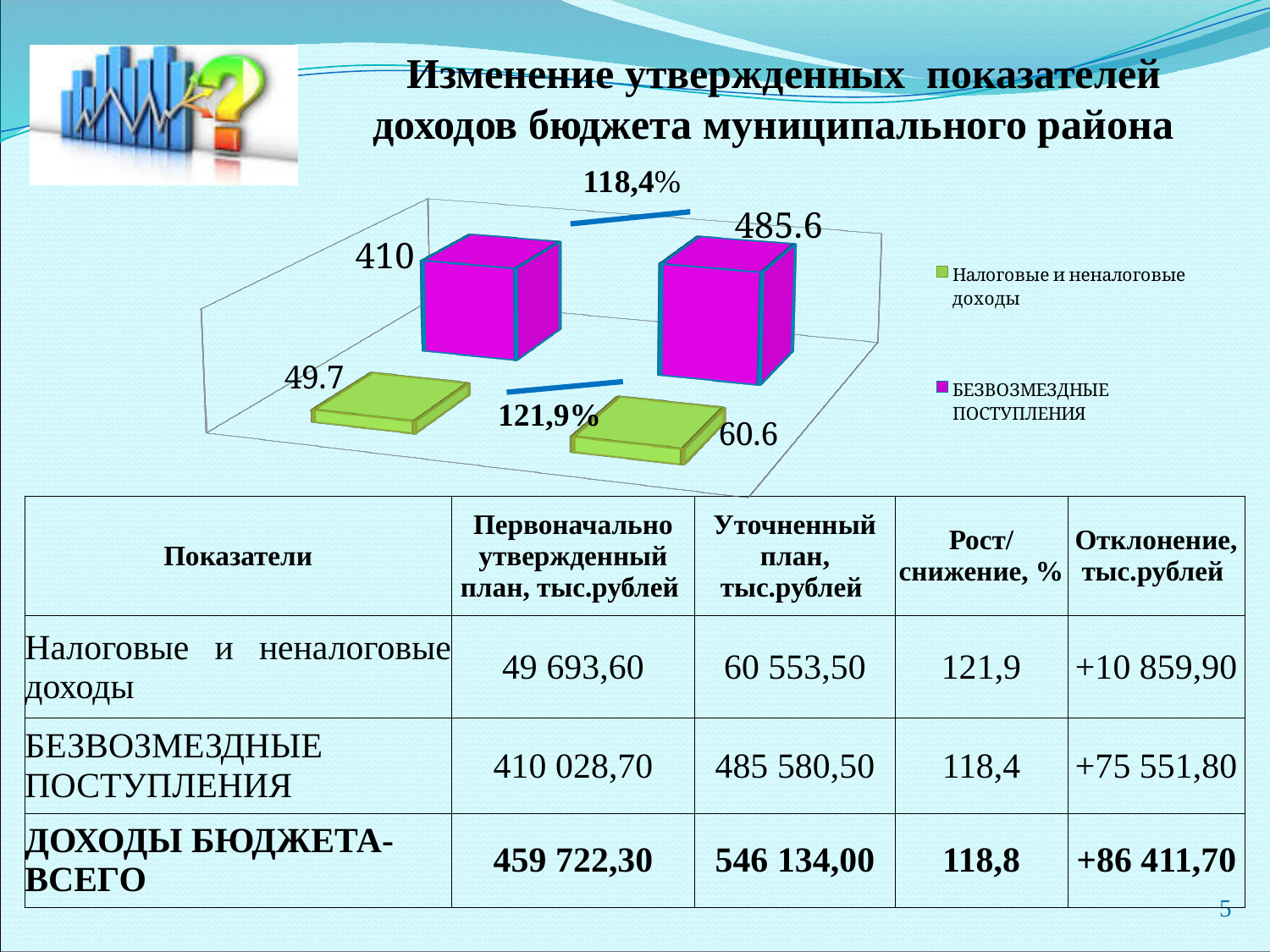
What is the value of the right (second) bar for the series 'БЕЗВОЗМЕЗДНЫЕ ПОСТУПЛЕНИЯ'? 485.6 What growth percentage is annotated on the chart for the series 'БЕЗВОЗМЕЗДНЫЕ ПОСТУПЛЕНИЯ'? 118,4% Which series has the highest value on the chart? БЕЗВОЗМЕЗДНЫЕ ПОСТУПЛЕНИЯ What is the value of the right (second) bar for the series 'Налоговые и неналоговые доходы'? 60.6 Do the values of the series 'Налоговые и неналоговые доходы' rise or fall from the left bar to the right bar? rise What kind of chart is shown on the slide? bar chart What is the difference between the two bars of the series 'БЕЗВОЗМЕЗДНЫЕ ПОСТУПЛЕНИЯ' (485.6 and 410)? 75.6 What is the difference between the two bars of the series 'Налоговые и неналоговые доходы' (60.6 and 49.7)? 10.9 Which series has the lowest value on the chart? Налоговые и неналоговые доходы How many series does the chart legend list? 2 What is the value of the left (first) bar for the series 'Налоговые и неналоговые доходы'? 49.7 What is the value of the left (first) bar for the series 'БЕЗВОЗМЕЗДНЫЕ ПОСТУПЛЕНИЯ'? 410